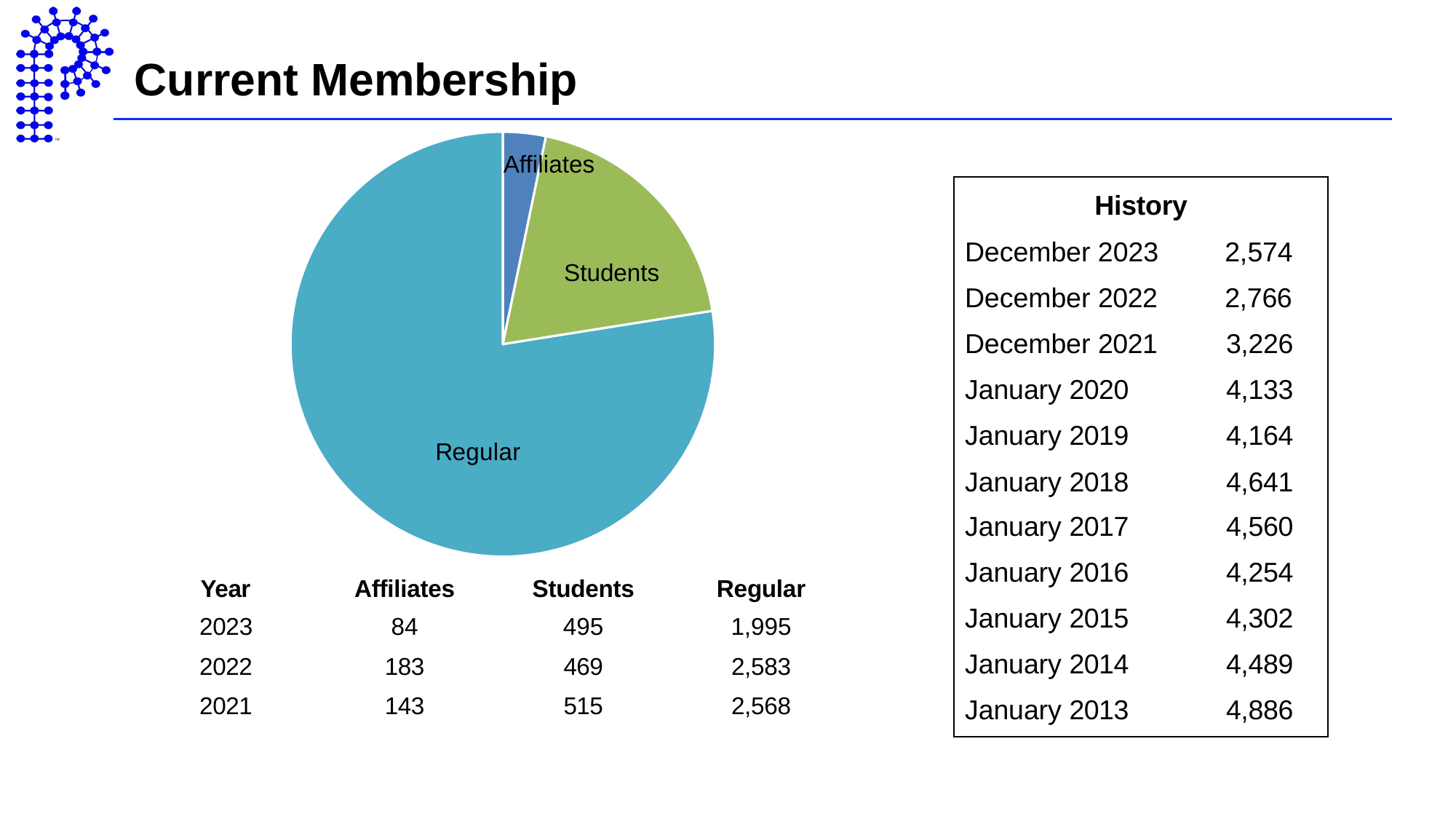
According to the table below the pie chart, how many Regular members were there in 2023? 1,995 Using the 2023 row of the table below the pie chart, how many more Students than Affiliates were there? 411 According to the table below the pie chart, how many Students were there in 2023? 495 Which slice of the pie chart is the largest? Regular Using the 2023 row of the table below the pie chart, what is the total membership across Affiliates, Students and Regular? 2,574 How many slices does the pie chart have? 3 Which slice is larger in the pie chart, Students or Affiliates? Students Which slice of the pie chart is the smallest? Affiliates Which category is shown by the green slice of the pie chart? Students According to the table below the pie chart, how many Affiliates were there in 2023? 84 What kind of chart is shown on the slide? pie chart What colour is the Regular slice of the pie chart? teal blue